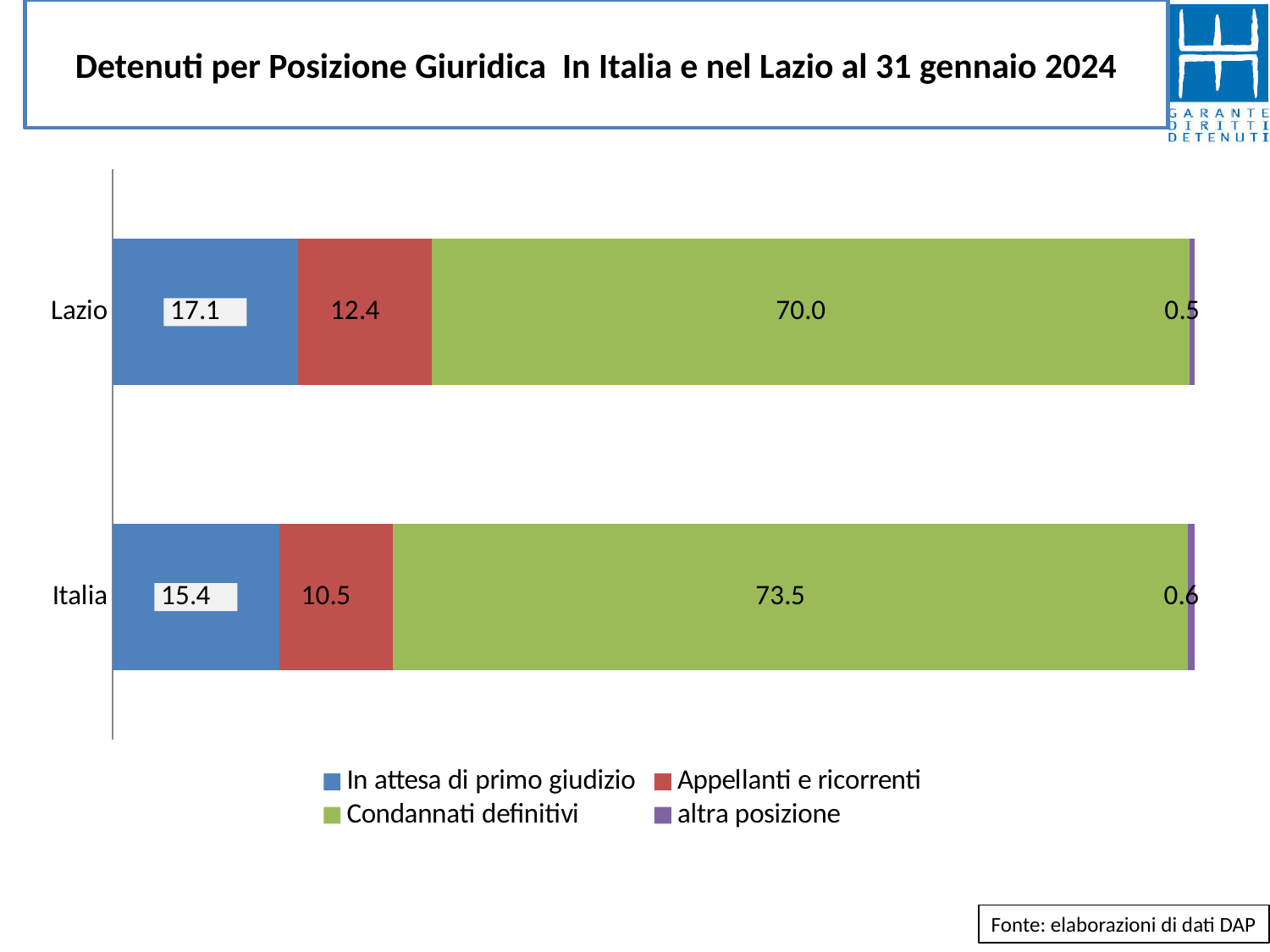
What is the value for "Condannati definitivi" for Italia? 73.5 How many series does the legend list? 4 What is the value for "In attesa di primo giudizio" for Lazio? 17.1 Which series has the highest value for Italia? Condannati definitivi Which series has the lowest value for Lazio? altra posizione What is the difference between the "Condannati definitivi" values for Italia and Lazio? 3.5 Which category has the higher value for "In attesa di primo giudizio", Lazio or Italia? Lazio What is the difference between the "Appellanti e ricorrenti" values for Lazio and Italia? 1.9 What kind of chart is shown on the slide? Stacked bar chart What is the value for "altra posizione" for Italia? 0.6 What is the value for "Appellanti e ricorrenti" for Lazio? 12.4 Which category has the higher value for "Condannati definitivi", Lazio or Italia? Italia